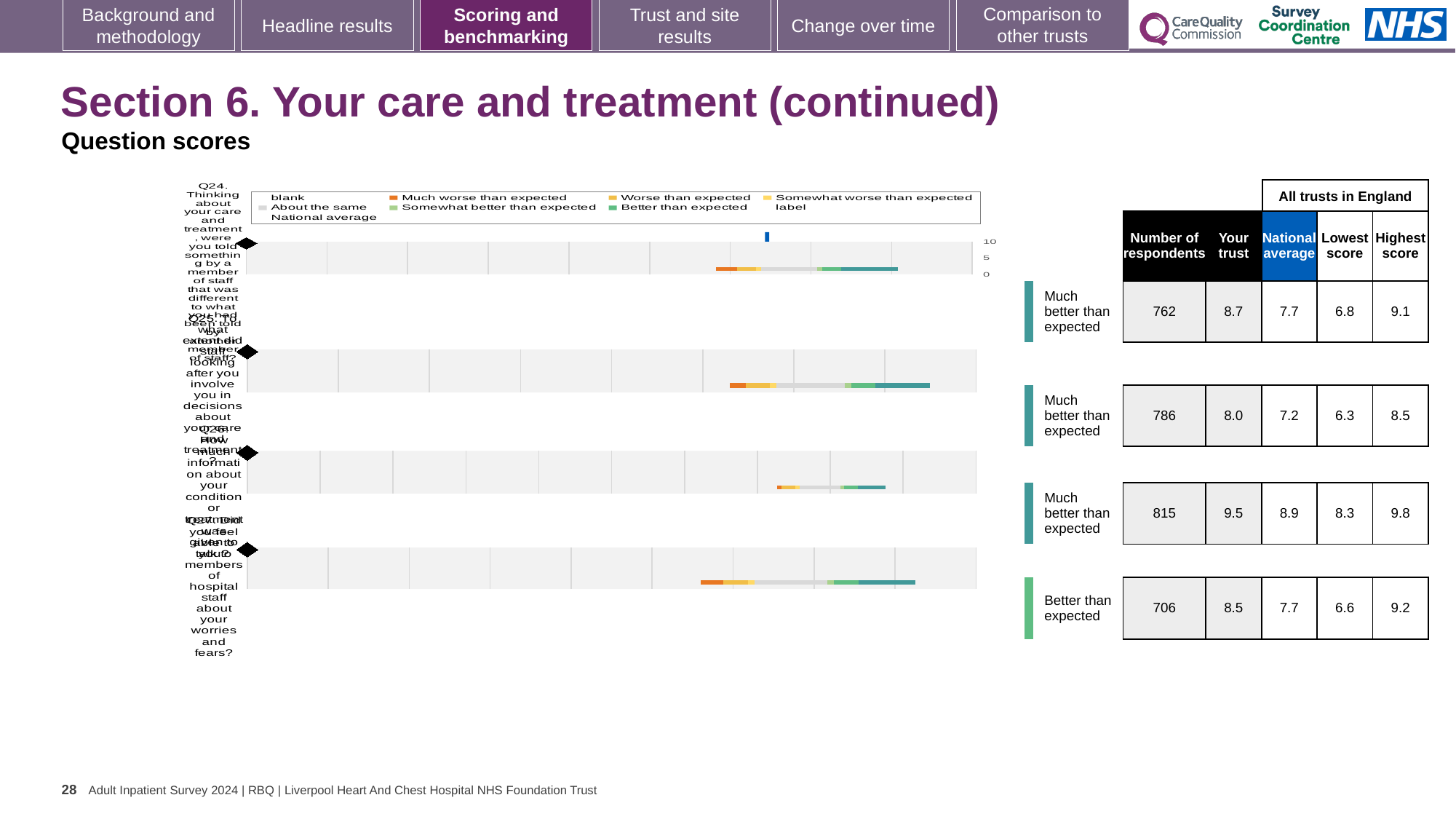
In the table beside the charts, which row has the lowest number of respondents? the fourth row (Q27), 706 In the legend, which colour represents 'Much worse than expected'? orange In the table beside the charts, what is the difference between the 'Your trust' score and the national average in the second row (Q25)? 0.8 In the table beside the charts, is the 'Your trust' score in the fourth row (Q27) larger or smaller than the national average? larger How many separate question charts are shown on the slide? 4 What kind of chart is used for the question scores on this slide? bar chart What is the highest value shown on the axis of the Q24 chart? 10 In the table beside the charts, what is the 'Your trust' score for the first row (Q24)? 8.7 How many entries does the legend above the charts list? 9 In the table beside the charts, what is the national average for the third row (Q26)? 8.9 In the table beside the charts, which row has the highest 'Your trust' score? the third row (Q26), 9.5 In the table beside the charts, what is the highest score among all trusts in England for the first row (Q24)? 9.1